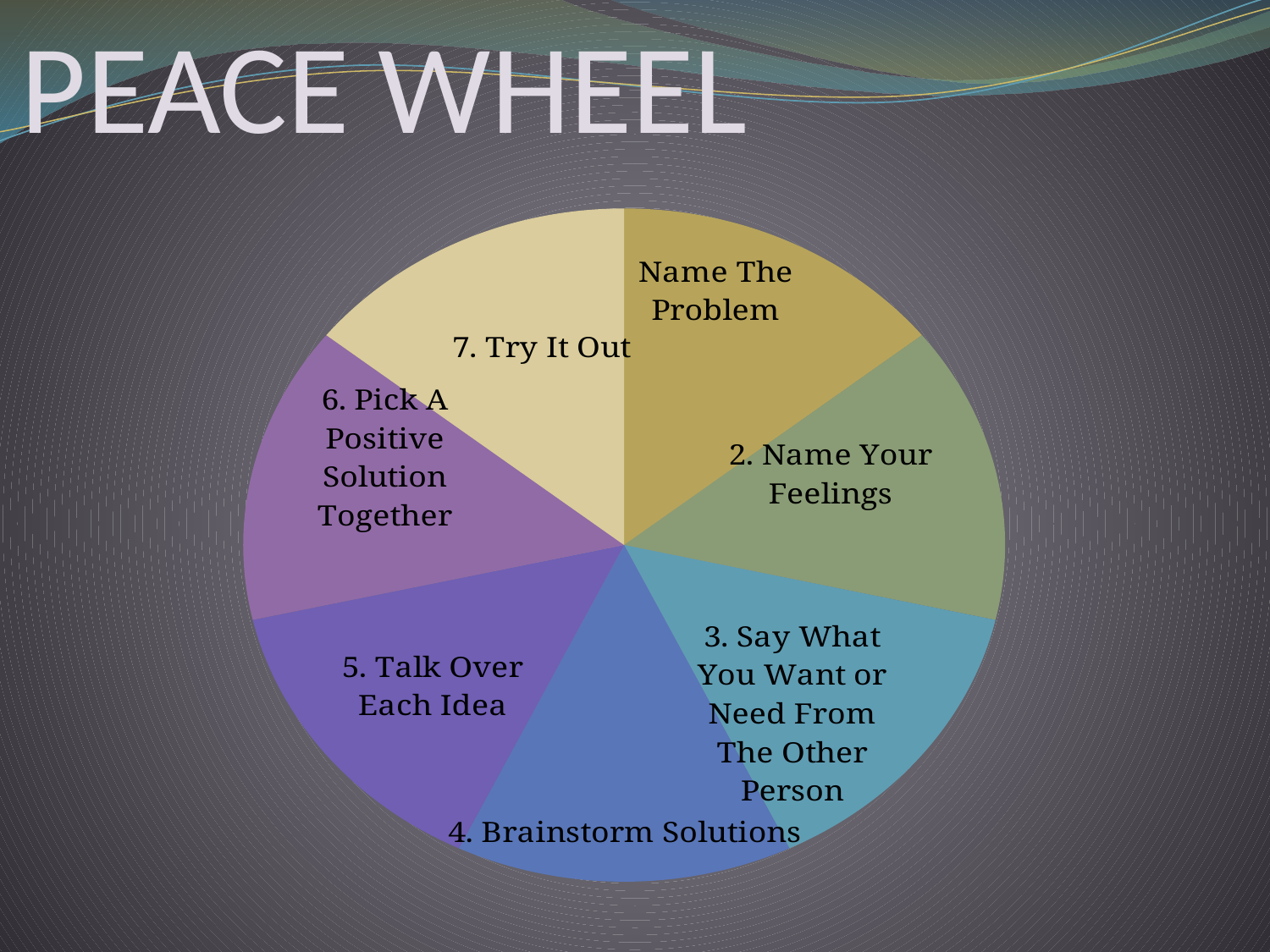
How many slices does the pie chart have? 7 What is the title of the slide containing the pie chart? PEACE WHEEL What is the label of step 2 in the pie chart? Name Your Feelings What kind of chart is shown on the slide? pie chart Which step number is labeled "Talk Over Each Idea" in the pie chart? 5 Which slice label in the pie chart has no step number in front of it? Name The Problem Which step number is labeled "Brainstorm Solutions" in the pie chart? 4 Which step number is labeled "Pick A Positive Solution Together" in the pie chart? 6 What is the label of step 3 in the pie chart? Say What You Want or Need From The Other Person What is the label of step 7 in the pie chart? Try It Out What colour is the slice labeled "4. Brainstorm Solutions"? blue